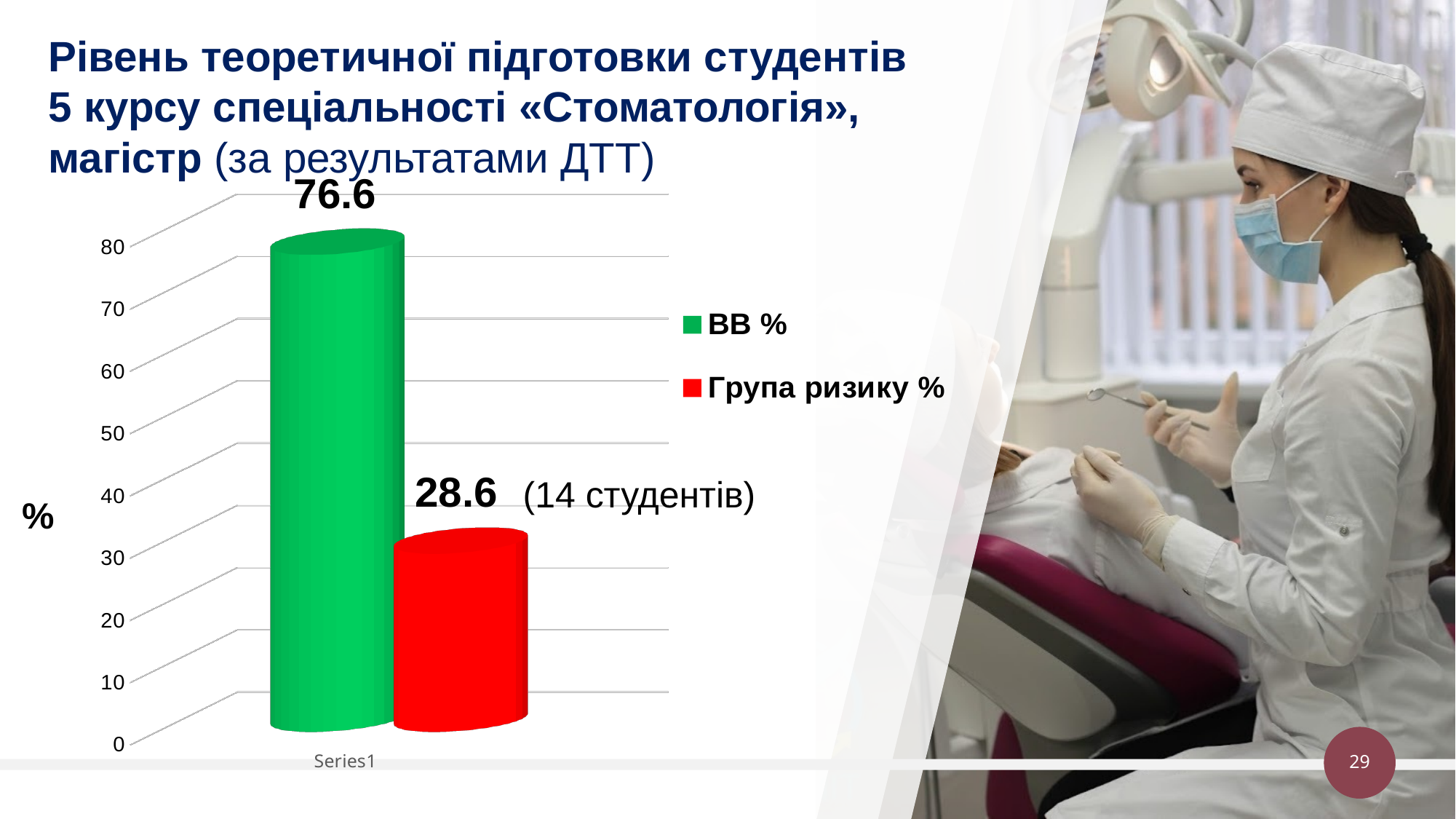
What kind of chart is shown on the slide? Bar chart Which series has the higher value, "ВВ %" or "Група ризику %"? ВВ % What colour is the bar for "Група ризику %"? Red Is the value for "Група ризику %" greater or less than 30? less How many series does the legend list? 2 How many students does the slide say are in the risk group ("Група ризику")? 14 студентів What is the label on the vertical axis of the chart? % What is the difference between the "ВВ %" value and the "Група ризику %" value? 48 Which series has the lowest value? Група ризику % Is the value for "ВВ %" greater or less than 70? greater What is the value for the "Група ризику %" series? 28.6 What is the value for the "ВВ %" series? 76.6